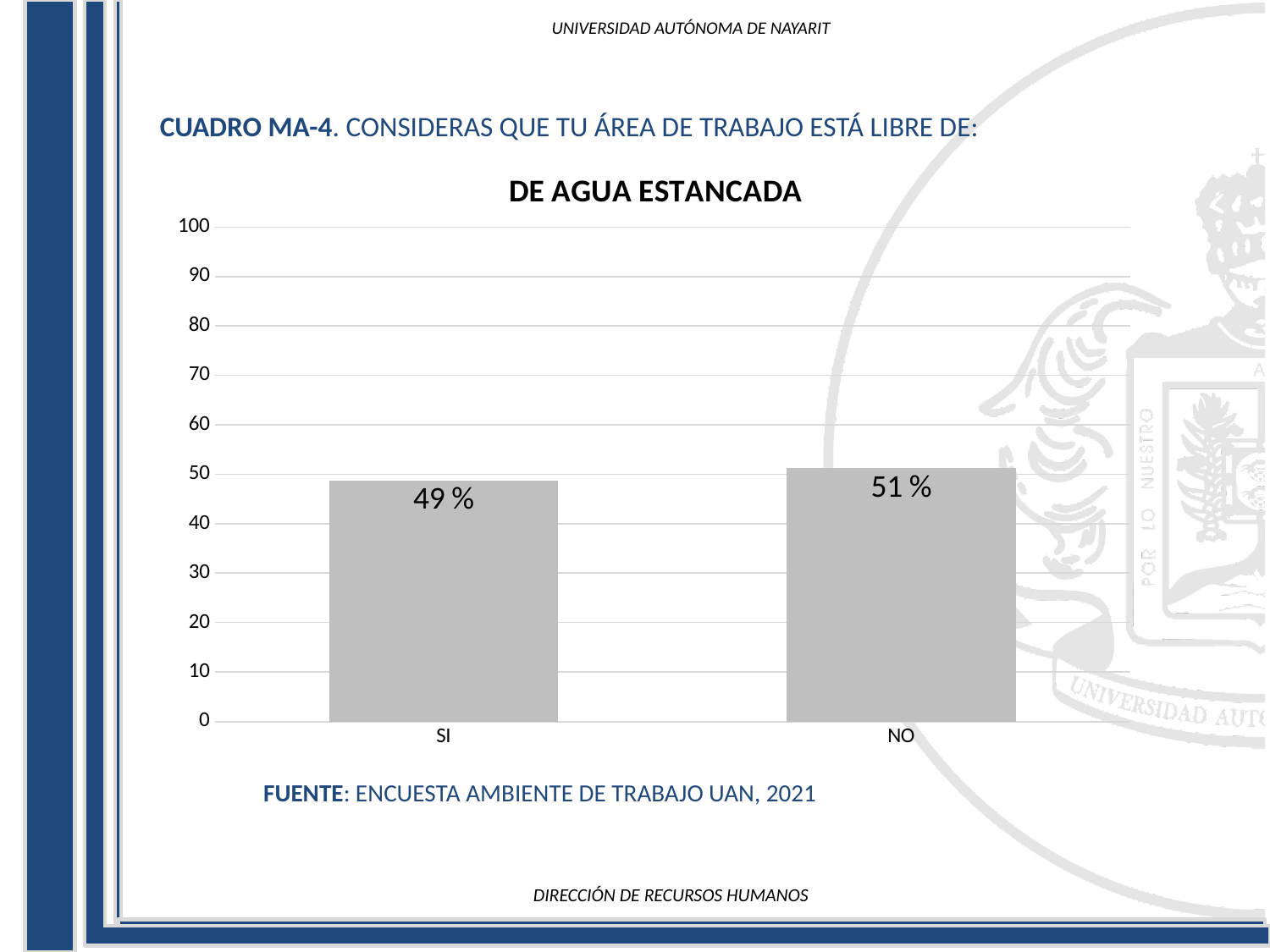
Is the value for SI greater or less than 50? less What is the value for SI? 49 % Which category has the lowest value? SI Is the value for NO greater or less than 50? greater Which category has the highest value? NO What is the difference between the values for NO and SI? 2 % Which is larger, the value for SI or the value for NO? NO What kind of chart is shown? bar chart How many categories are shown on the x axis? 2 What is the title of the chart? DE AGUA ESTANCADA What is the value for NO? 51 % What is the maximum value shown on the y axis? 100